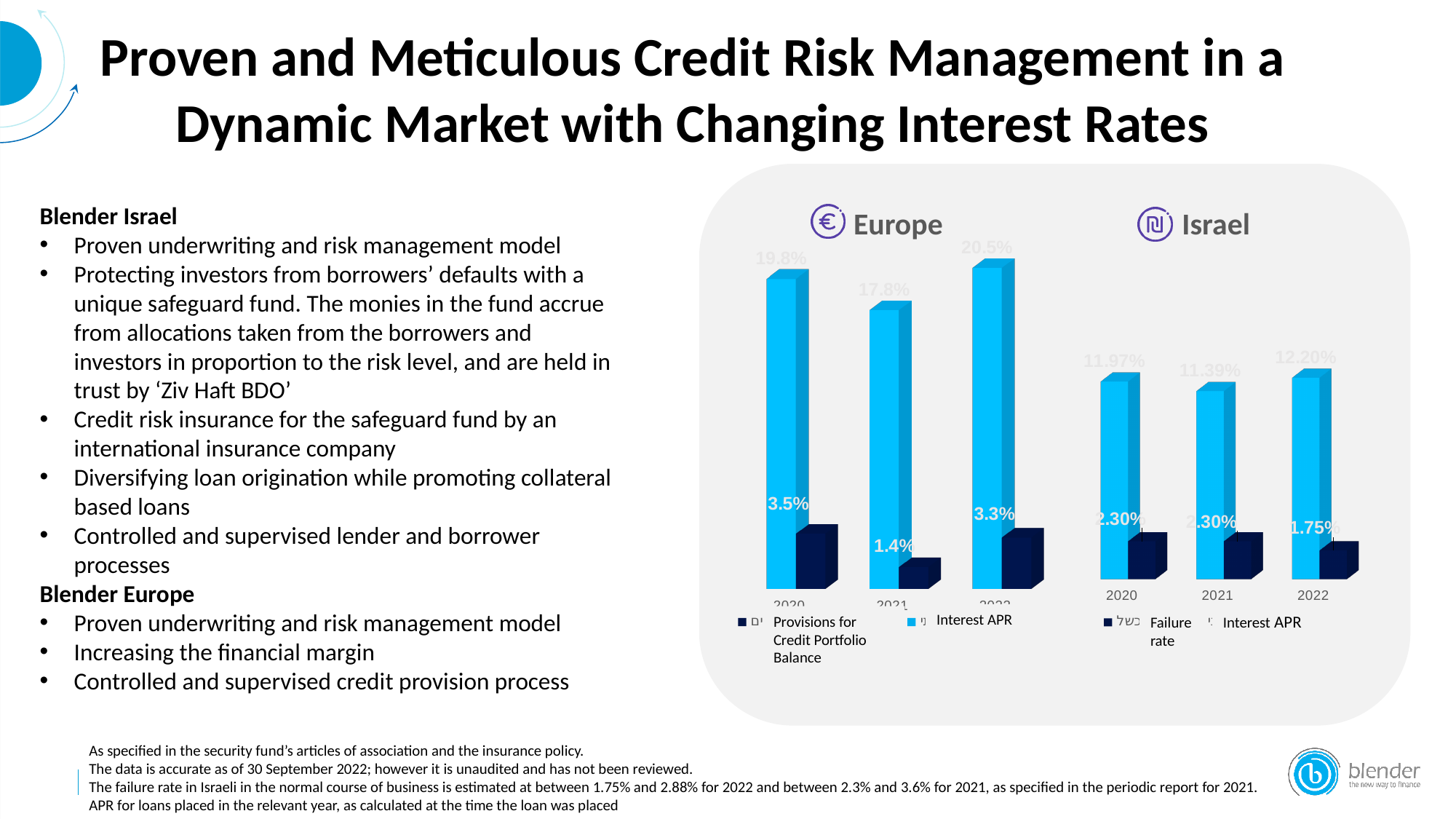
In the Europe chart, which year has the lowest Interest APR? 2021 What type of chart is used for the Israel data? Bar chart In the Europe chart, what is the difference between the Interest APR in 2022 and in 2021? 2.7% In the Europe chart, what is the value of Provisions for Credit Portfolio Balance in 2021? 1.4% In the Israel chart, what is the Failure rate for 2022? 1.75% How many years are shown on the x axis of the Israel chart? 3 In the Israel chart, what is the Interest APR for 2020? 11.97% Which is larger: the Europe Interest APR for 2020 or the Israel Interest APR for 2020? Europe Interest APR for 2020 In the Israel chart, what is the difference between the Failure rate in 2020 and in 2022? 0.55% In the Europe chart, what is the Interest APR for 2022? 20.5% In the Israel chart, which year has the highest Interest APR? 2022 How many series does the legend of the Europe chart list? 2